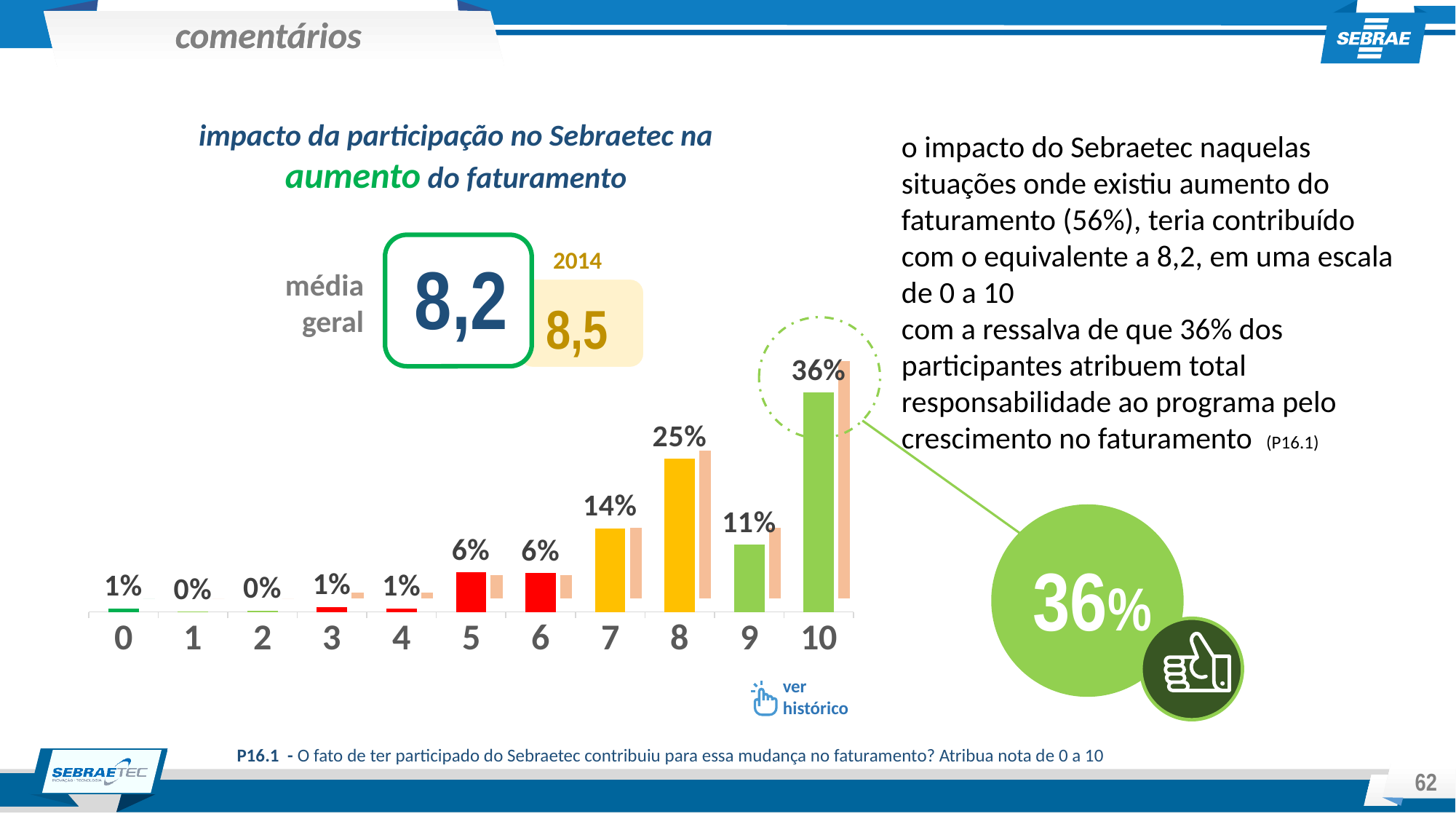
Which score on the 0 to 10 scale has the highest percentage of respondents? 10 What percentage of respondents gave a score of 9? 11% What percentage of respondents gave a score of 10 for the impact of Sebraetec on the increase in revenue? 36% Which has a larger share of respondents: a score of 8 or a score of 9? 8 What type of chart is used to show the distribution of scores? bar chart How many score categories are shown on the x axis of the chart? 11 What is the difference in percentage points between the share of respondents giving a score of 10 and those giving a score of 8? 11 What percentage of respondents gave a score of 8? 25% What is the overall average (média geral) score shown on the slide? 8,2 What percentage of respondents gave a score of 7? 14% What was the average score in 2014 according to the slide? 8,5 What percentage of respondents gave a score of 5? 6%